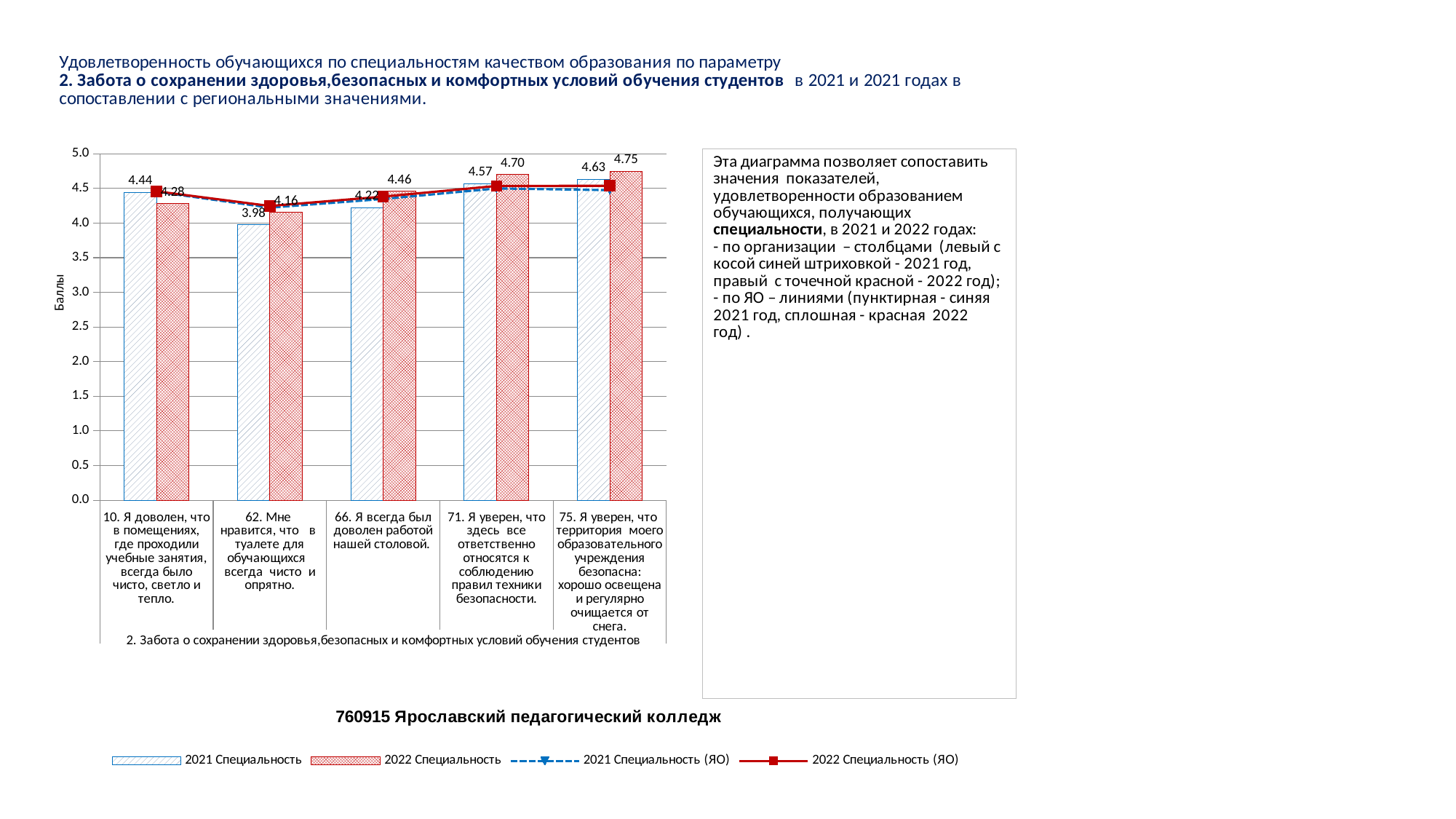
What type of chart is used for the 2021 Специальность and 2022 Специальность series? Bar chart Which item has the highest 2022 Специальность bar? 75. Я уверен, что территория моего образовательного учреждения безопасна: хорошо освещена и регулярно очищается от снега. How many series does the legend list? 4 What is the value of the 2022 Специальность bar for item 75 (Я уверен, что территория моего образовательного учреждения безопасна)? 4.75 How many survey items (categories) are shown on the x axis? 5 What is the label of the vertical axis? Баллы For item 10, which is larger: the 2021 Специальность bar or the 2022 Специальность bar? 2021 Специальность What is the value of the 2022 Специальность bar for item 62 (Мне нравится, что в туалете для обучающихся всегда чисто и опрятно)? 4.16 What is the value of the 2021 Специальность bar for item 10 (Я доволен, что в помещениях, где проходили учебные занятия, всегда было чисто, светло и тепло)? 4.44 Which item has the lowest 2021 Специальность bar? 62. Мне нравится, что в туалете для обучающихся всегда чисто и опрятно. What is the difference between the 2022 and 2021 Специальность values for item 66 (Я всегда был доволен работой нашей столовой)? 0.24 Is the 2021 Специальность value for item 62 greater or less than 4.0? less